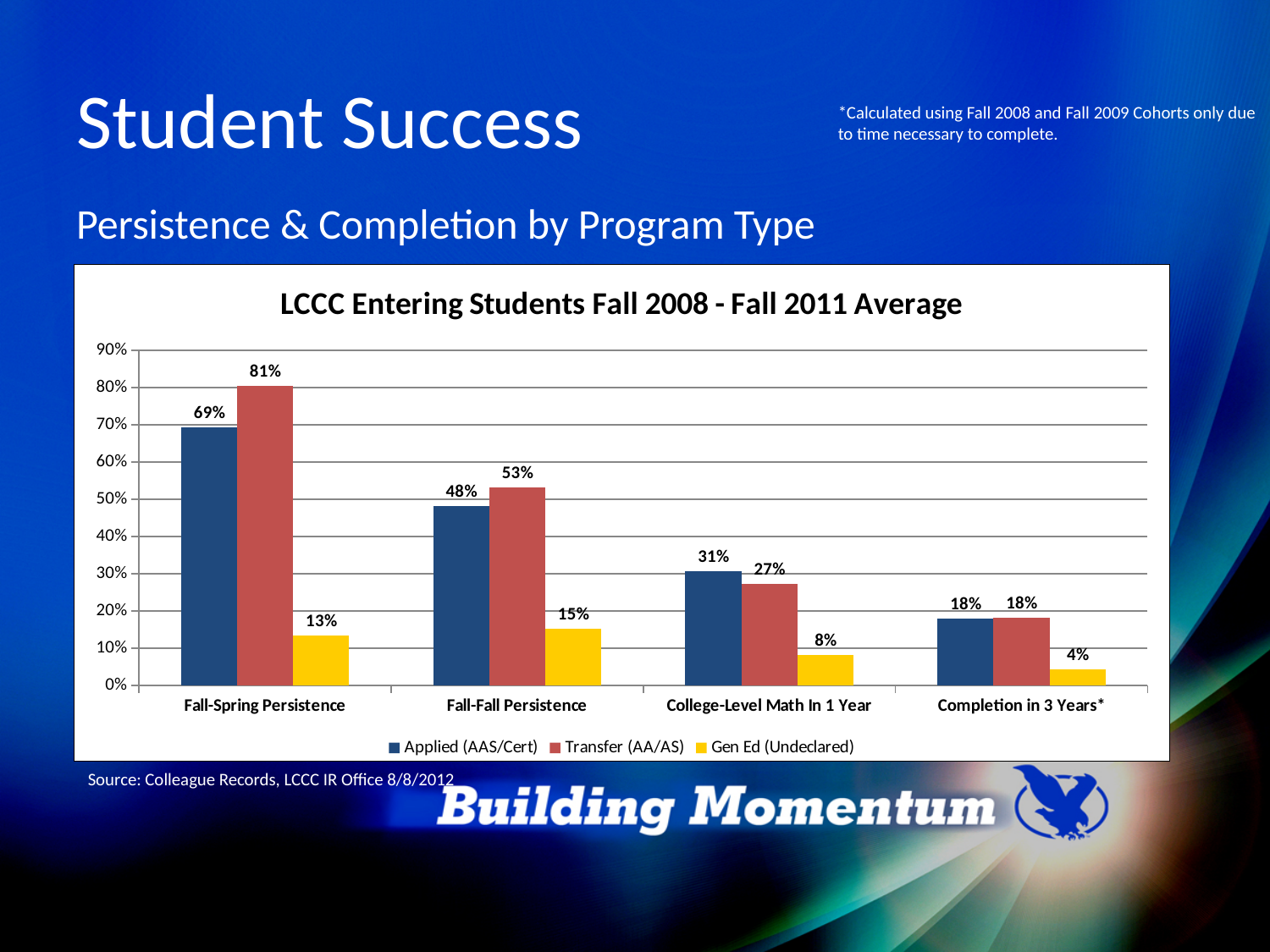
What is the Fall-Fall Persistence value for Gen Ed (Undeclared) students? 15% For College-Level Math In 1 Year, which is larger: Applied (AAS/Cert) or Transfer (AA/AS)? Applied (AAS/Cert) How many series does the legend list? 3 What is the College-Level Math In 1 Year value for Applied (AAS/Cert) students? 31% Do the Applied (AAS/Cert) values rise or fall from left to right across the categories? Fall What is the title of the chart? LCCC Entering Students Fall 2008 - Fall 2011 Average What is the difference between the Transfer (AA/AS) and Applied (AAS/Cert) values for Fall-Spring Persistence? 12% What is the Fall-Spring Persistence value for Transfer (AA/AS) students? 81% Which program type has the highest Fall-Spring Persistence? Transfer (AA/AS) What kind of chart is shown? Bar chart Which category has the lowest value for Gen Ed (Undeclared)? Completion in 3 Years* How many categories are shown on the x axis? 4